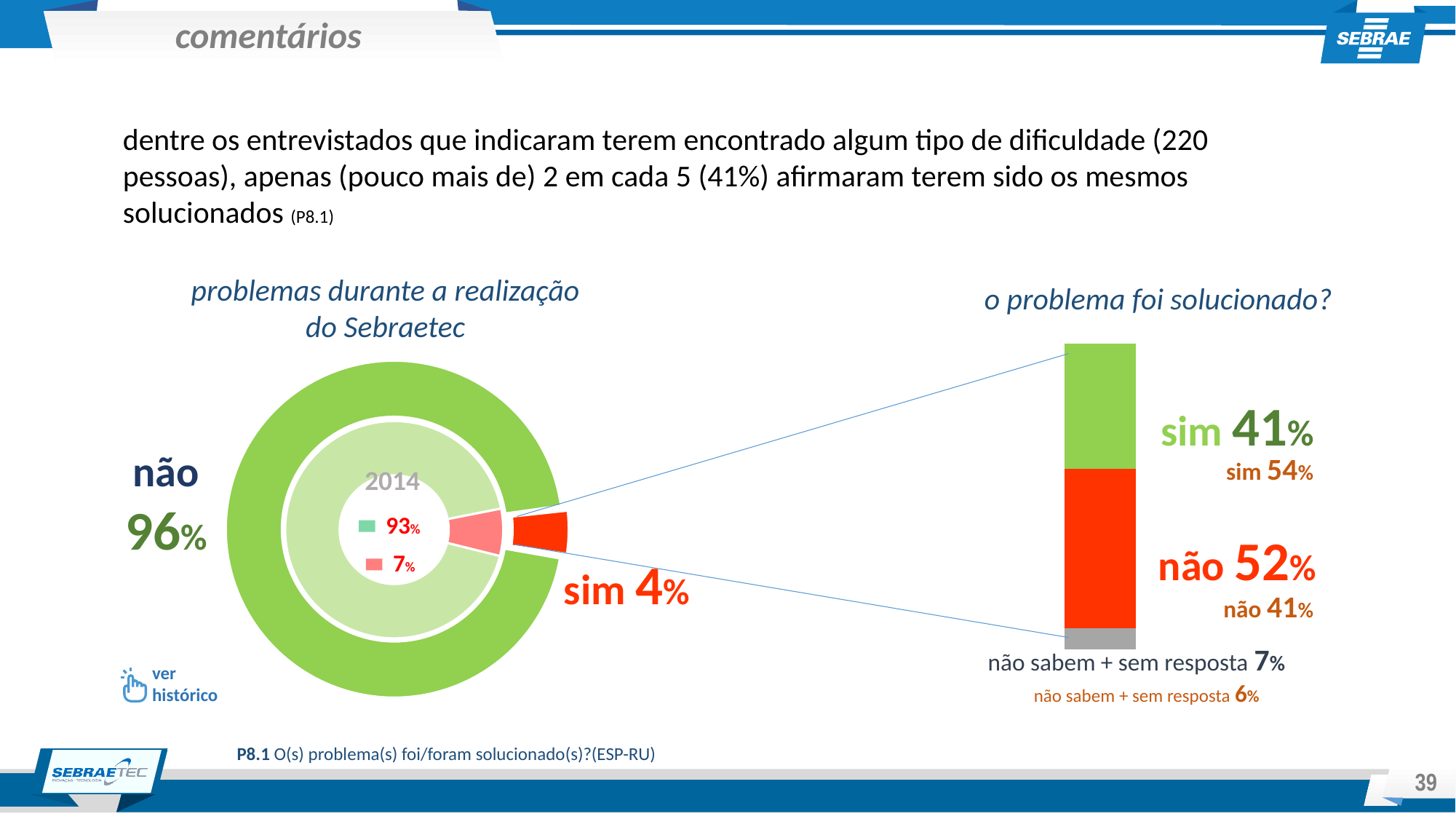
In the chart 'problemas durante a realização do Sebraetec', what are the two values shown for the inner 2014 ring? 93% and 7% What kind of chart is 'problemas durante a realização do Sebraetec'? Pie (donut) chart In the chart 'problemas durante a realização do Sebraetec', what is the difference between the 'não' and 'sim' shares? 92 percentage points In the chart 'o problema foi solucionado?', what percentage is 'não sabem + sem resposta'? 7% In the chart 'o problema foi solucionado?', what is the difference between the 'não' and 'sim' shares? 11 percentage points In the chart 'o problema foi solucionado?', what percentage answered 'sim'? 41% In the chart 'problemas durante a realização do Sebraetec', what percentage of respondents answered 'sim'? 4% In the chart 'o problema foi solucionado?', which category has the highest share? não In the chart 'problemas durante a realização do Sebraetec', what percentage of respondents answered 'não'? 96% In the chart 'problemas durante a realização do Sebraetec', what year is labelled on the inner ring? 2014 In the chart 'o problema foi solucionado?', what percentage answered 'não'? 52% In the chart 'problemas durante a realização do Sebraetec', which category has the larger share, 'não' or 'sim'? não